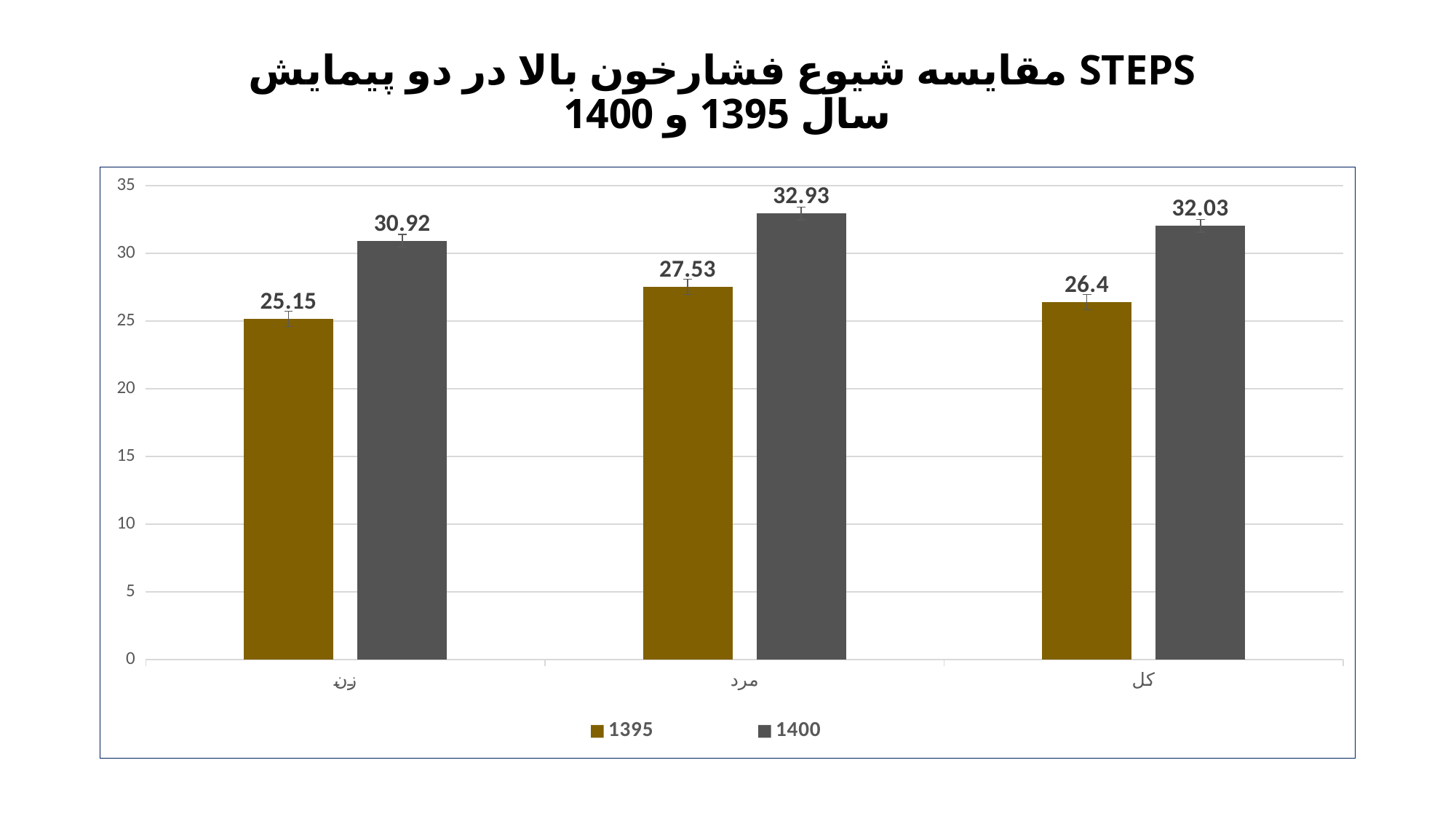
What is the difference between the 1400 and 1395 values for زن? 5.77 What is the value for مرد in the 1395 series? 27.53 Which is larger for مرد: the 1395 value or the 1400 value? 1400 What kind of chart is shown on the slide? bar chart How many categories are shown on the x axis? 3 What is the value for زن in the 1395 series? 25.15 Which category has the lowest value in the 1395 series? زن What is the difference between the 1400 and 1395 values for کل? 5.63 What is the value for کل in the 1400 series? 32.03 What is the value for مرد in the 1400 series? 32.93 Which category has the highest value in the 1400 series? مرد How many series does the legend list? 2